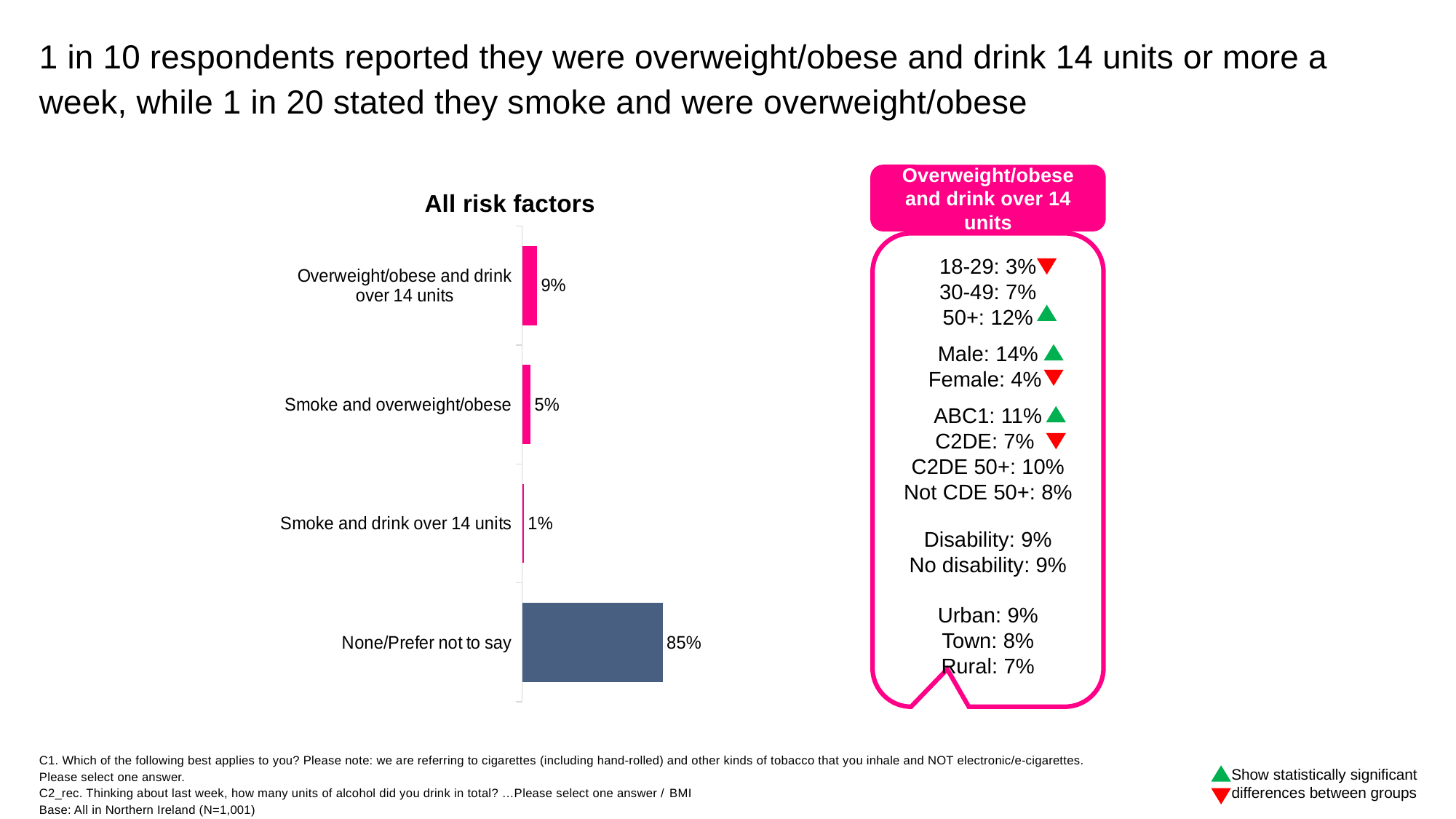
What is the value for 'Overweight/obese and drink over 14 units' in the 'All risk factors' chart? 9% Which category has the lowest value in the 'All risk factors' chart? Smoke and drink over 14 units What is the value for 'None/Prefer not to say' in the 'All risk factors' chart? 85% Which is larger in the 'All risk factors' chart: 'Smoke and overweight/obese' or 'Smoke and drink over 14 units'? Smoke and overweight/obese What is the value for 'Smoke and drink over 14 units' in the 'All risk factors' chart? 1% What is the title of the chart on the slide? All risk factors What is the difference between 'Overweight/obese and drink over 14 units' and 'Smoke and overweight/obese' in the 'All risk factors' chart? 4% What type of chart is the 'All risk factors' chart? Bar chart Which category has the highest value in the 'All risk factors' chart? None/Prefer not to say Which bar in the 'All risk factors' chart is coloured differently (dark blue) from the others? None/Prefer not to say What is the value for 'Smoke and overweight/obese' in the 'All risk factors' chart? 5% How many categories are shown in the 'All risk factors' chart? 4